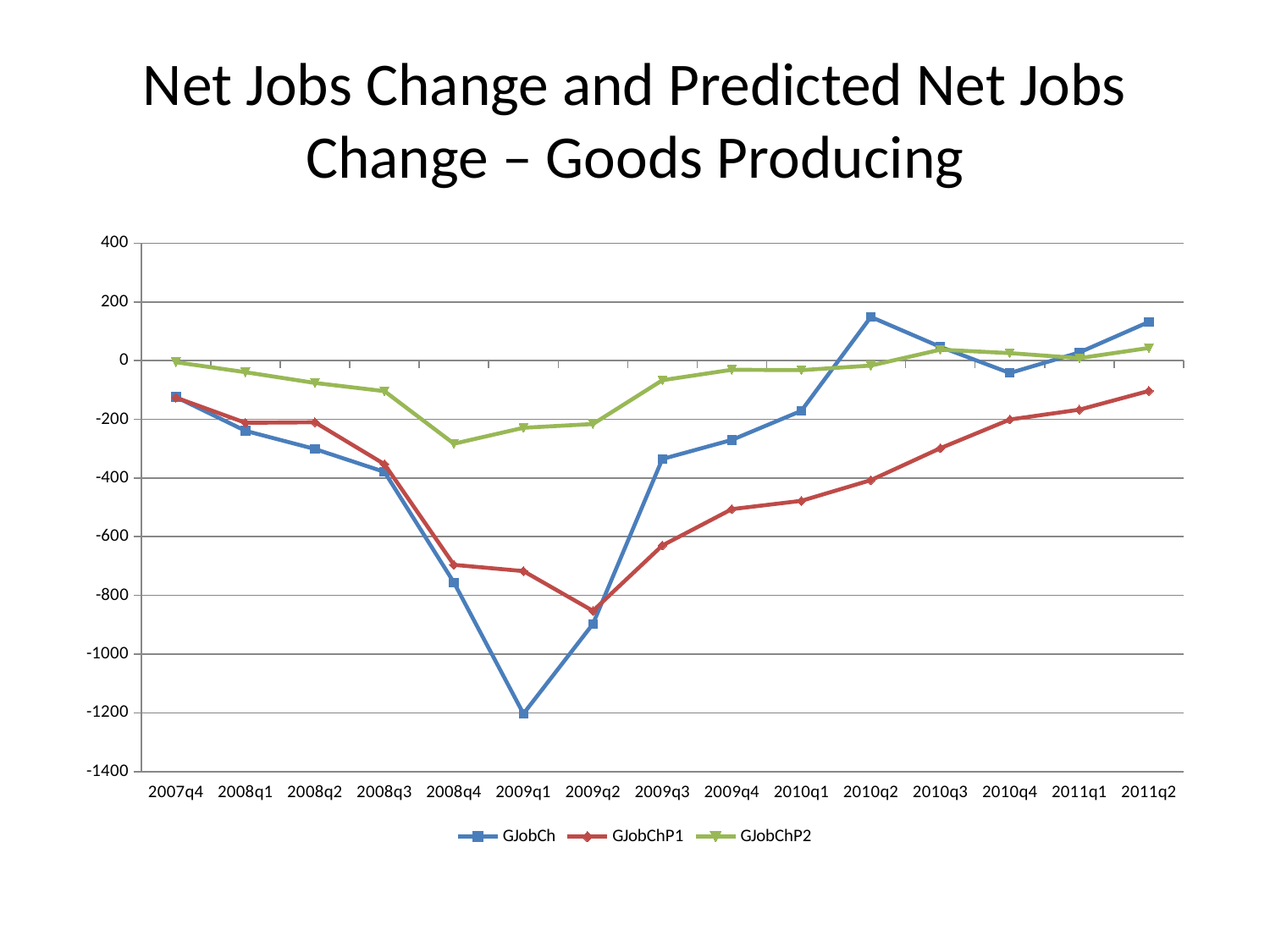
In which quarter does the GJobCh series reach its lowest value? 2009q1 Does the GJobChP1 series rise or fall from 2009q2 to 2011q2? rise What kind of chart is shown on the slide? line chart In which quarter does the GJobChP2 series reach its lowest value? 2008q4 What is the title of the chart? Net Jobs Change and Predicted Net Jobs Change – Goods Producing How many quarters are plotted along the x axis? 15 How many series does the legend list? 3 In 2009q1, which series has the larger value, GJobCh or GJobChP2? GJobChP2 Is the value of GJobCh in 2009q1 greater or less than -1000? less Is the value of GJobCh in 2010q2 greater or less than 0? greater Is the value of GJobChP1 in 2009q2 greater or less than -800? less In which quarter does the GJobChP1 series reach its lowest value? 2009q2